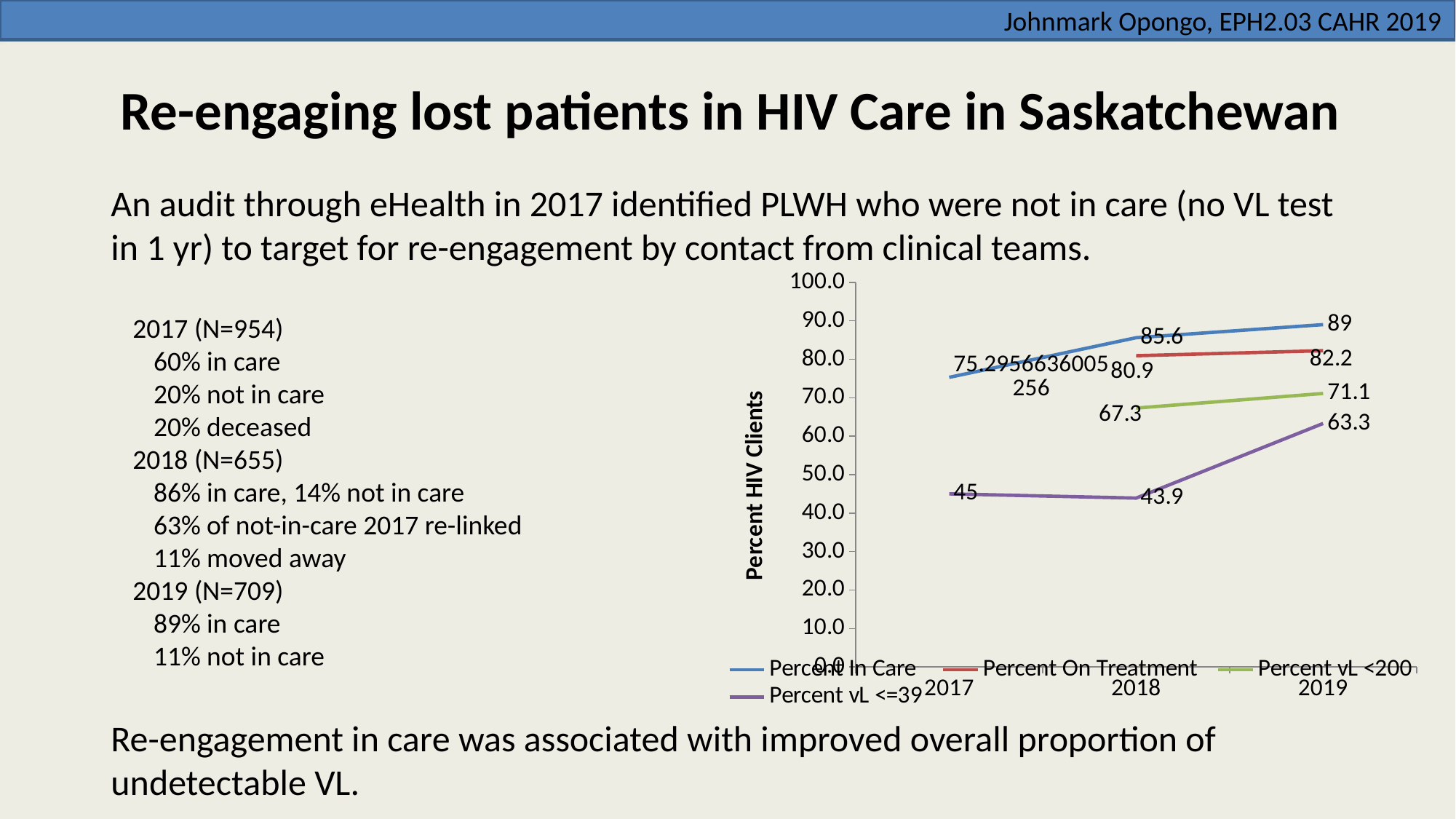
What is the value for Percent vL <=39 in 2019? 63.3 What is the value for Percent In Care in 2019? 89 How many series does the chart legend list? 4 What is the difference between Percent vL <=39 in 2019 and in 2018? 19.4 What is the value for Percent In Care in 2018? 85.6 In which year is Percent vL <=39 lowest? 2018 Which is larger in 2019, Percent On Treatment or Percent vL <200? Percent On Treatment What is the value for Percent vL <200 in 2018? 67.3 What is the value for Percent On Treatment in 2019? 82.2 What is the label of the y axis of the chart? Percent HIV Clients What type of chart is shown on the slide? line chart How many years are shown on the x axis of the chart? 3